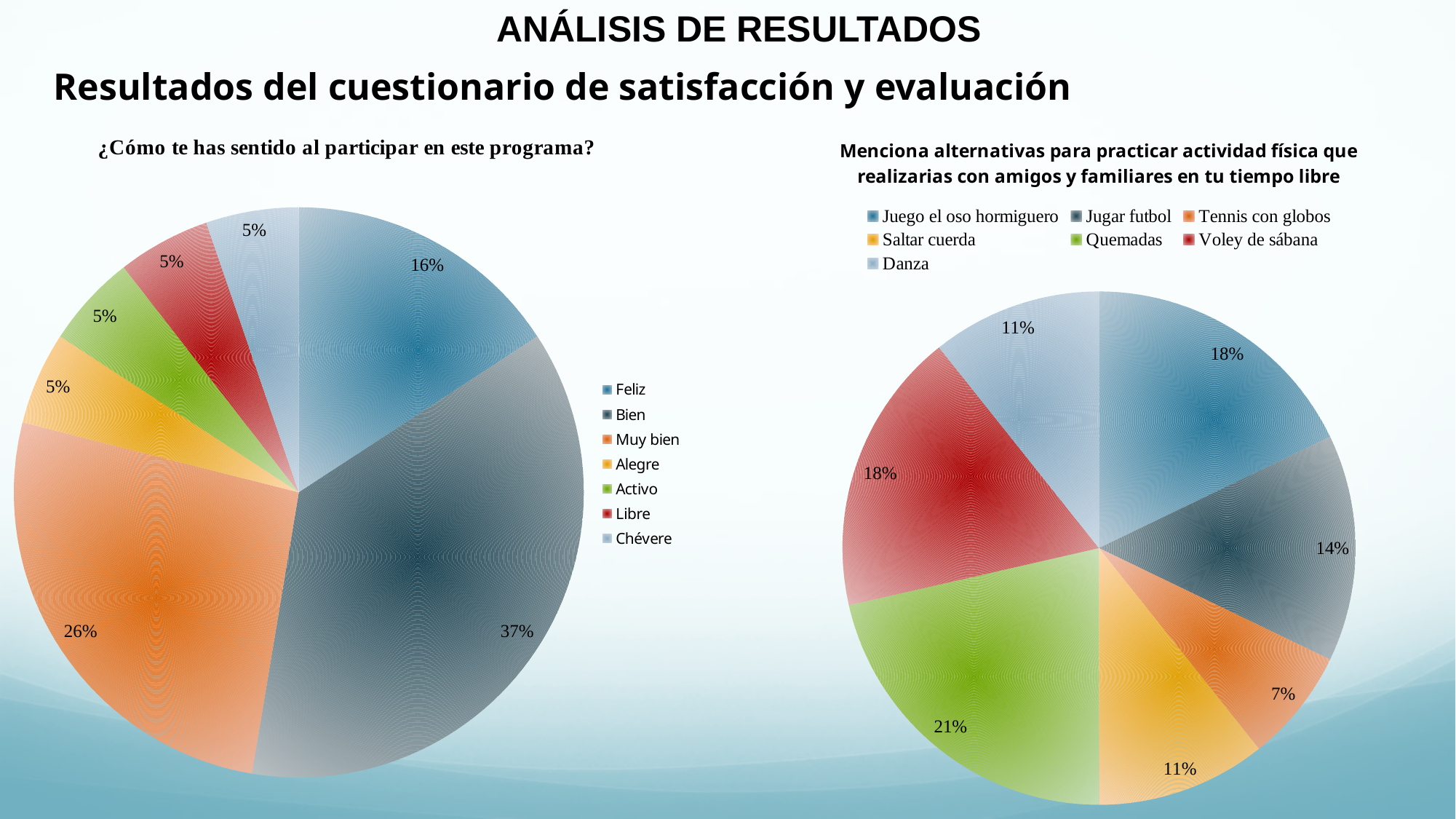
In the right chart (Menciona alternativas para practicar actividad física...), what colour is the 'Quemadas' slice? Green In the left chart (¿Cómo te has sentido al participar en este programa?), what share of responses is 'Bien'? 37% In the right chart (Menciona alternativas para practicar actividad física...), which is larger: 'Jugar futbol' or 'Voley de sábana'? Voley de sábana In the right chart (Menciona alternativas para practicar actividad física...), what is the difference between the 'Quemadas' and 'Saltar cuerda' shares? 10% In the left chart (¿Cómo te has sentido al participar en este programa?), which category has the largest slice? Bien In the left chart (¿Cómo te has sentido al participar en este programa?), how many categories does the legend list? 7 In the right chart (Menciona alternativas para practicar actividad física...), what share is 'Quemadas'? 21% What kind of chart is used on the left side of the slide? Pie chart In the right chart (Menciona alternativas para practicar actividad física...), which category has the smallest slice? Tennis con globos In the right chart (Menciona alternativas para practicar actividad física...), what share is 'Tennis con globos'? 7% In the left chart (¿Cómo te has sentido al participar en este programa?), what is the difference between the 'Bien' and 'Feliz' shares? 21% In the left chart (¿Cómo te has sentido al participar en este programa?), what share of responses is 'Muy bien'? 26%